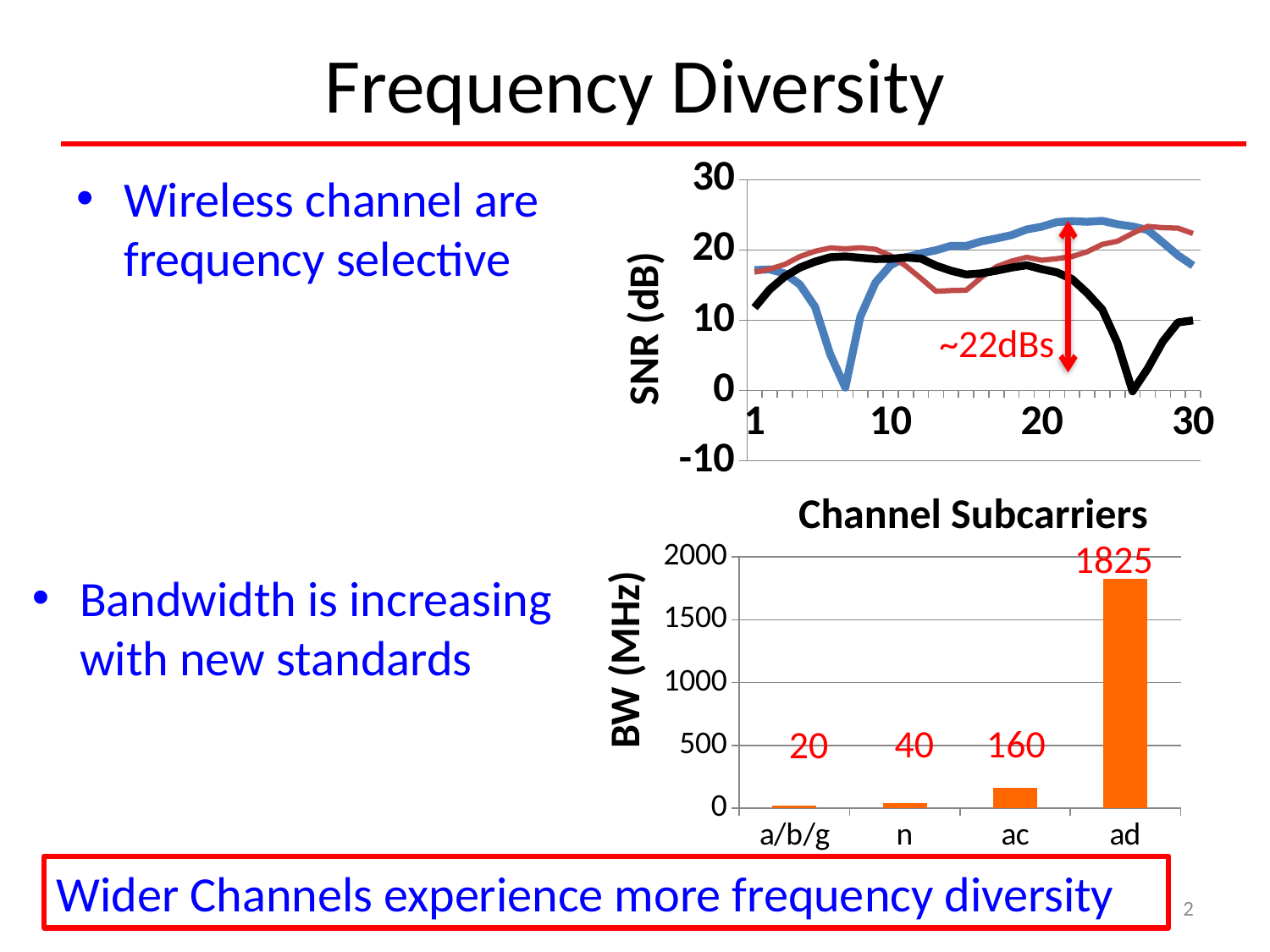
In the bottom bar chart, what is the difference in bandwidth between ad and ac? 1665 In the bottom bar chart, which has a larger bandwidth, n or ac? ac In the bottom bar chart, which category has the highest bandwidth? ad In the bottom bar chart, what is the bandwidth value for n? 40 In the bottom bar chart, which category has the lowest bandwidth? a/b/g What kind of chart is the top chart on the slide? line chart In the bottom bar chart, do the bandwidth values rise or fall from a/b/g to ad? rise How many categories are shown in the bottom bar chart? 4 In the bottom bar chart, what is the bandwidth value for ad? 1825 What kind of chart is the bottom chart on the slide? bar chart In the bottom bar chart, what is the bandwidth value for a/b/g? 20 In the bottom bar chart, what is the bandwidth value for ac? 160